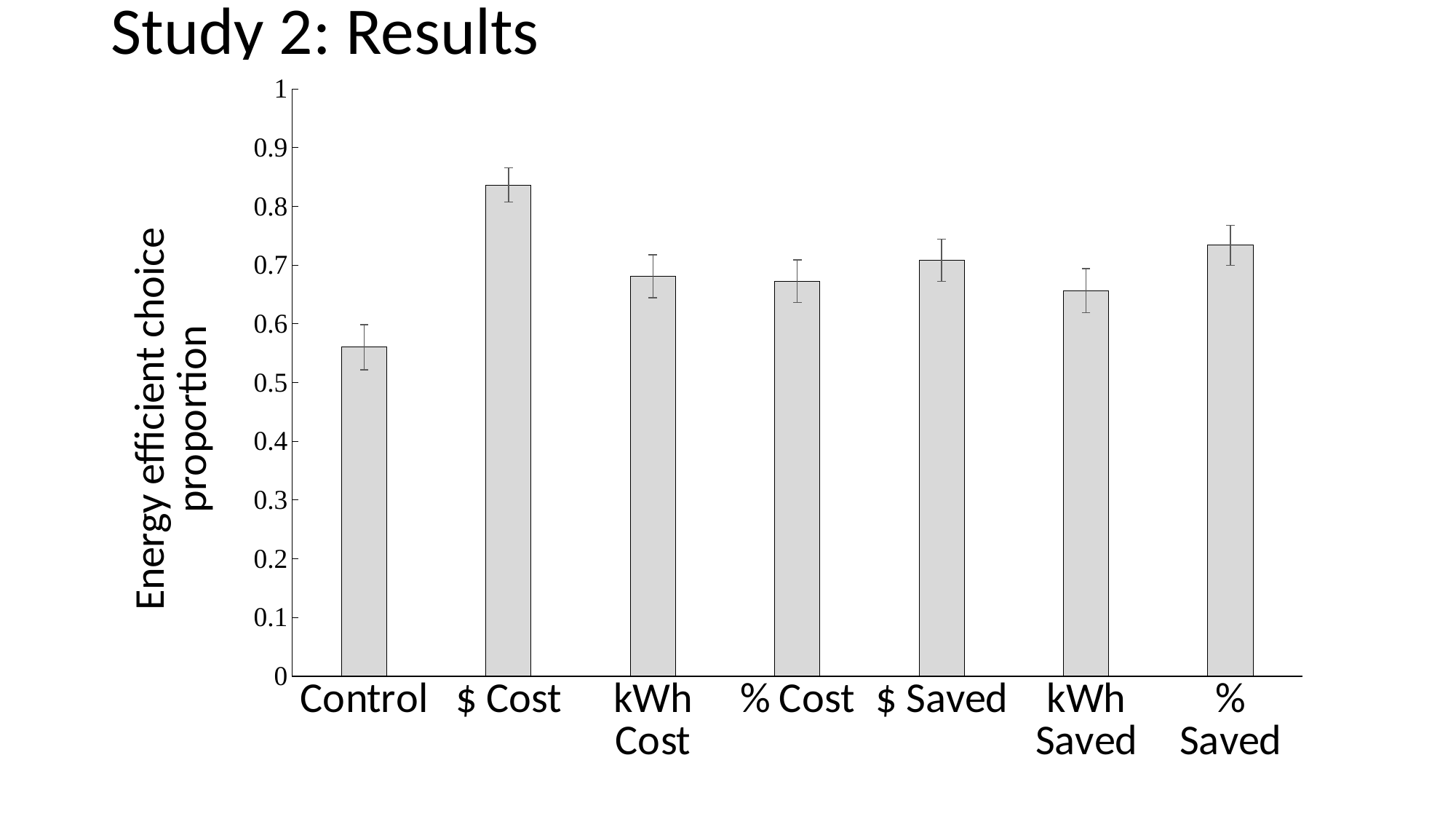
Which category has the lowest energy efficient choice proportion? Control Which is larger, the value for $ Cost or the value for % Saved? $ Cost Is the value for Control greater or less than 0.6? less Is the value for % Saved greater or less than 0.7? greater Is the value for $ Cost greater or less than 0.8? greater What is the label of the y axis? Energy efficient choice proportion What kind of chart is shown on the slide? bar chart What is the title of the slide? Study 2: Results Which is larger, the value for Control or the value for kWh Saved? kWh Saved Which category has the highest energy efficient choice proportion? $ Cost How many categories are plotted on the x axis? 7